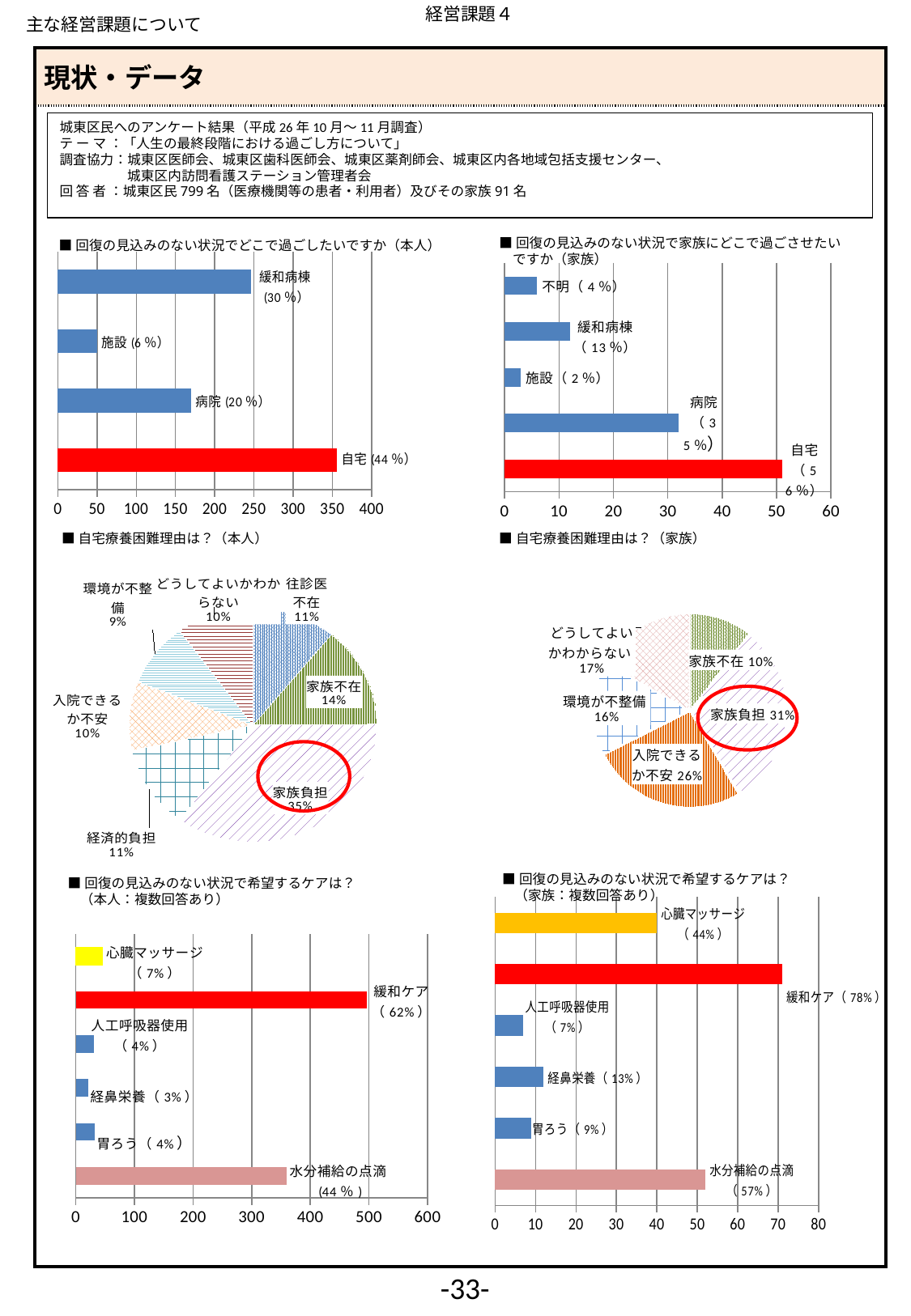
In the bottom-left chart (希望するケアは？（本人：複数回答あり）), what percentage is shown for 緩和ケア? 62% In the bottom-right chart (希望するケアは？（家族：複数回答あり）), which is larger, 心臓マッサージ or 水分補給の点滴? 水分補給の点滴 In the middle-right pie chart (自宅療養困難理由は？（家族）), what is the difference in percentage points between 入院できるか不安 and 環境が不整備? 10 In the top-right chart (家族にどこで過ごさせたいですか（家族）), how many categories are plotted? 5 In the top-left chart (回復の見込みのない状況でどこで過ごしたいですか（本人）), which category has the lowest percentage? 施設 In the top-right chart (家族にどこで過ごさせたいですか（家族）), what percentage is shown for 緩和病棟? 13% What kind of chart is the middle-left chart (自宅療養困難理由は？（本人）)? pie chart In the top-right chart (家族にどこで過ごさせたいですか（家族）), is the bar for 病院 greater or less than 30 on the axis? greater In the bottom-right chart (希望するケアは？（家族：複数回答あり）), what percentage is shown for 経鼻栄養? 13% In the middle-left pie chart (自宅療養困難理由は？（本人）), what share does 家族負担 have? 35% In the middle-right pie chart (自宅療養困難理由は？（家族）), which slice is the largest? 家族負担 In the top-left chart (回復の見込みのない状況でどこで過ごしたいですか（本人）), what percentage is shown for 自宅? 44%